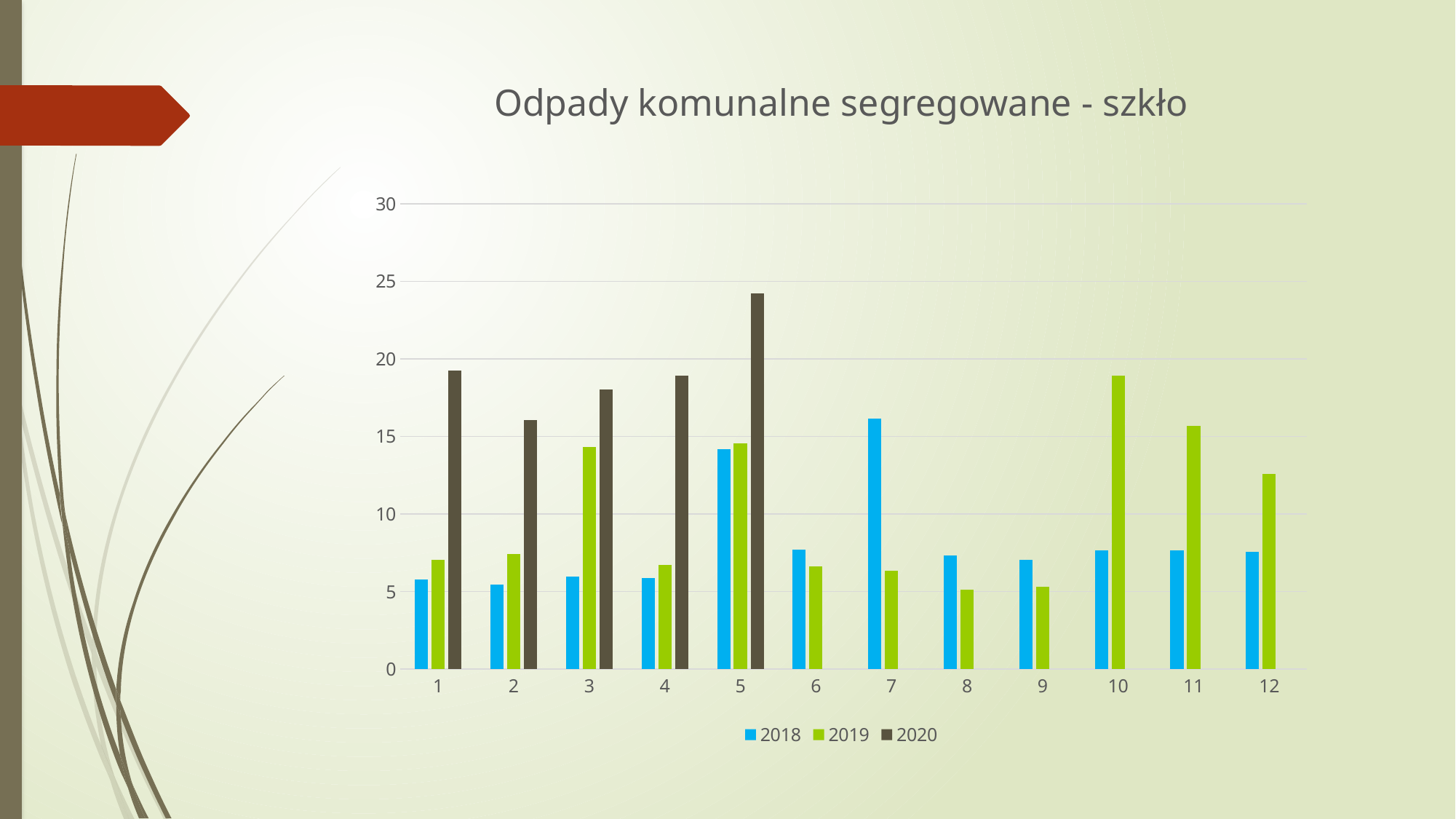
For which category is the 2019 value highest? 10 For which category is the 2018 value highest? 7 For which category is the 2020 value highest? 5 What is the title of the chart? Odpady komunalne segregowane - szkło What kind of chart is shown on the slide? bar chart How many categories are shown on the x axis? 12 Is the 2019 value for category 10 greater or less than 20? less How many series does the legend list? 3 Which is larger for category 11: the 2018 value or the 2019 value? 2019 Is the 2020 value for category 5 greater or less than 20? greater Which is larger: the 2020 value for category 1 or the 2020 value for category 2? category 1 Is the 2018 value for category 7 greater or less than 15? greater